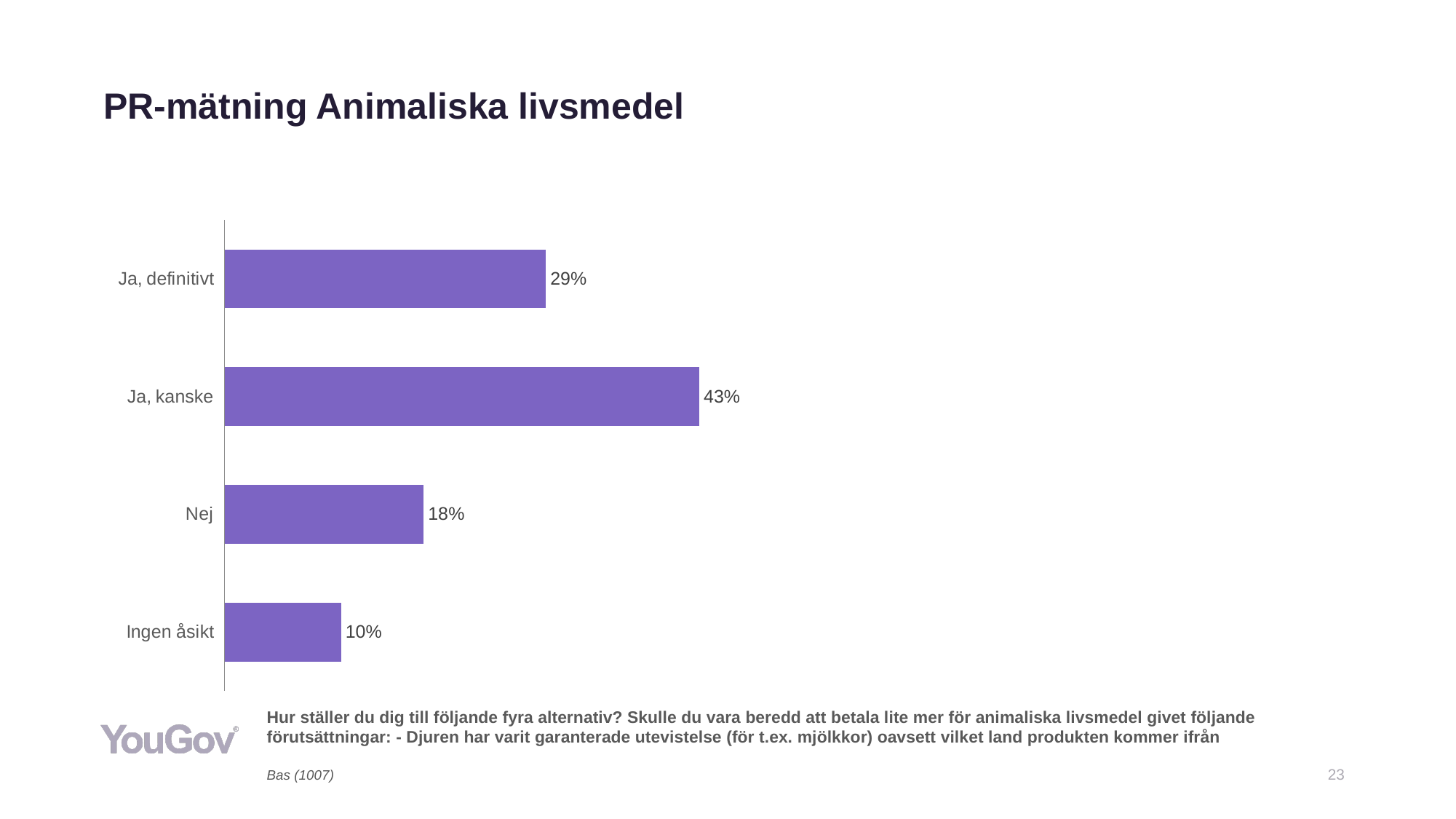
What is the title of the slide containing the chart? PR-mätning Animaliska livsmedel What is the value for "Ja, definitivt"? 29% What is the value for "Nej"? 18% What kind of chart is shown on the slide? Bar chart Which category has the highest value? Ja, kanske What is the value for "Ja, kanske"? 43% What is the value for "Ingen åsikt"? 10% How many categories are shown in the chart? 4 What is the difference between the values for "Ja, kanske" and "Ja, definitivt"? 14% Which is larger, the value for "Ja, definitivt" or the value for "Nej"? Ja, definitivt What is the difference between the values for "Nej" and "Ingen åsikt"? 8% Which category has the lowest value? Ingen åsikt